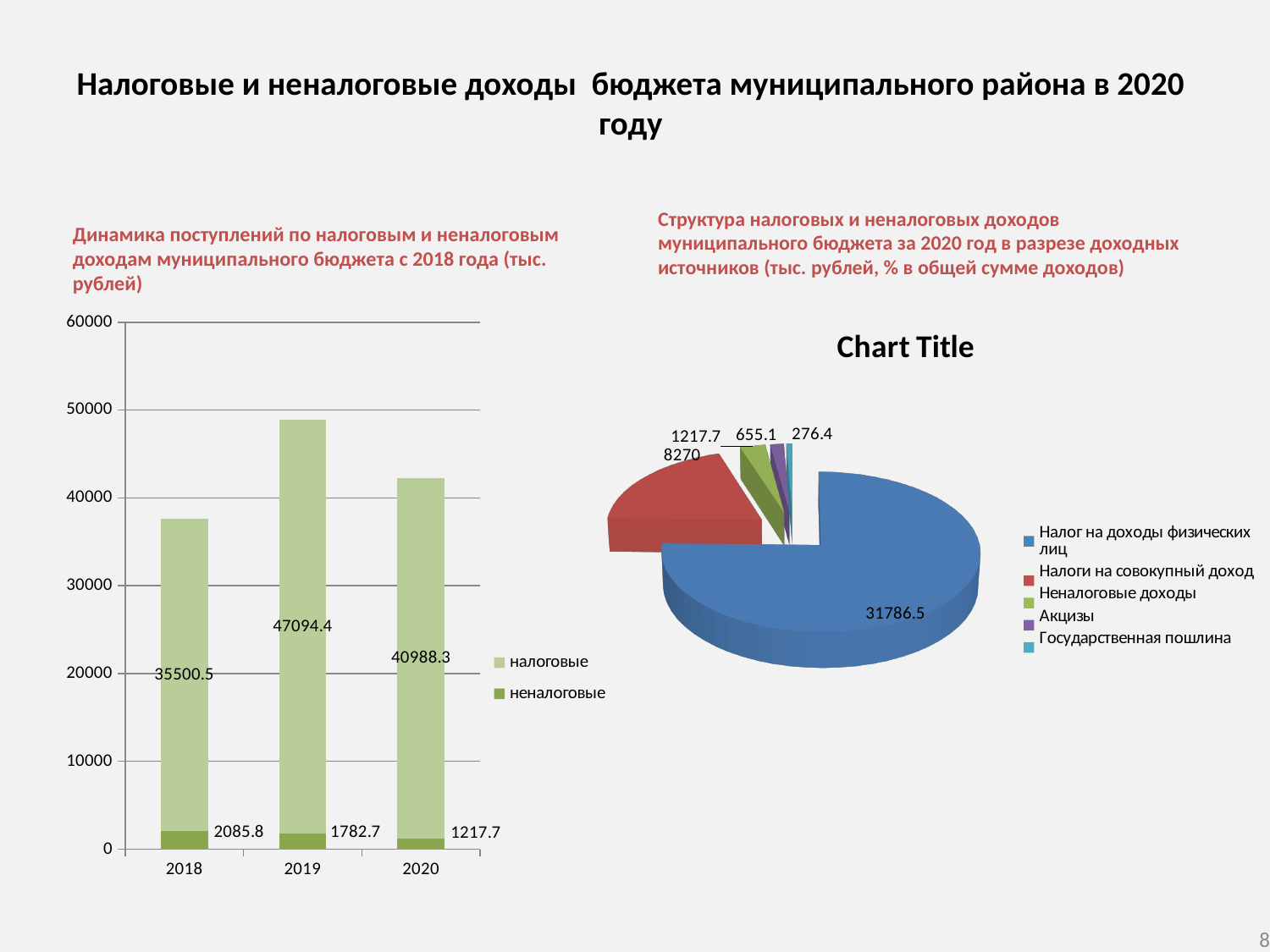
What kind of chart is the right chart titled 'Chart Title'? pie chart In the left chart (Динамика поступлений), what is the value of неналоговые for 2018? 2085.8 In the left chart (Динамика поступлений), how many series does the legend list? 2 In the right pie chart (Chart Title), what is the value for Налоги на совокупный доход? 8270 In the left chart (Динамика поступлений), what is the difference between the налоговые values for 2019 and 2020? 6106.1 In the left chart (Динамика поступлений), which year has the lowest неналоговые value? 2020 In the left chart (Динамика поступлений), what is the value of налоговые for 2019? 47094.4 In the left chart (Динамика поступлений), what is the total of the stacked bar for 2018? 37586.3 In the left chart (Динамика поступлений), do the неналоговые values rise or fall from 2018 to 2020? fall In the right pie chart (Chart Title), which category has the smallest value? Государственная пошлина In the left chart (Динамика поступлений), which year has the highest налоговые value? 2019 In the right pie chart (Chart Title), how many categories are shown? 5